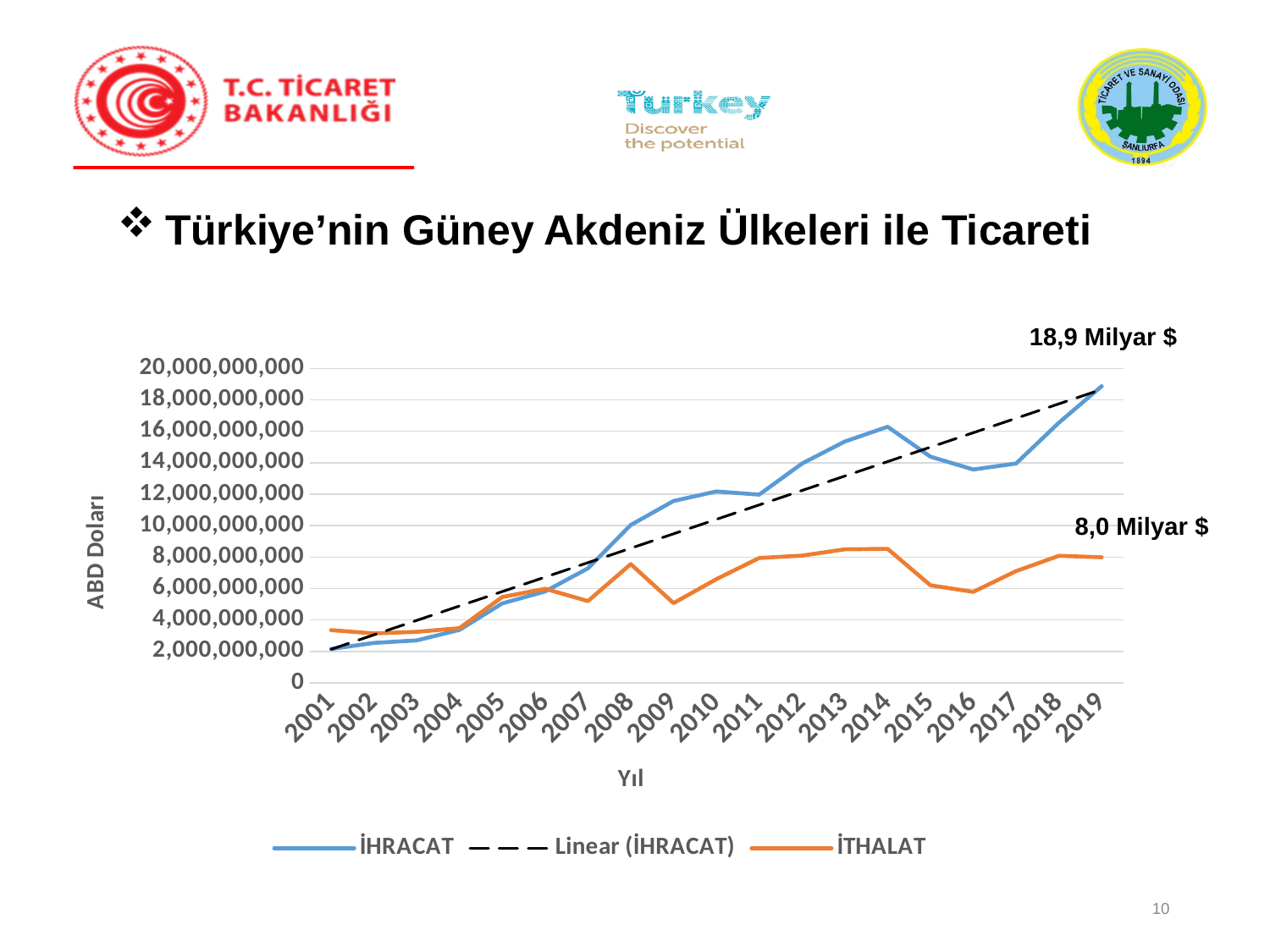
How many years are shown on the x axis of the chart? 19 What is the title of the vertical axis of the chart? ABD Doları How many series does the chart legend list? 3 Is the İTHALAT value for 2009 greater or less than 6,000,000,000? less In which year is the İHRACAT line at its highest? 2019 Is the İHRACAT value for 2014 greater or less than 14,000,000,000? greater What value is labelled for İTHALAT in 2019? 8,0 Milyar $ What is the difference between the labelled 2019 İHRACAT value and the labelled 2019 İTHALAT value? 10,9 Milyar $ What value is labelled for İHRACAT in 2019? 18,9 Milyar $ In 2001, which is larger, İHRACAT or İTHALAT? İTHALAT Does the İHRACAT line overall rise or fall from 2001 to 2019? rise What kind of chart is shown on the slide? line chart